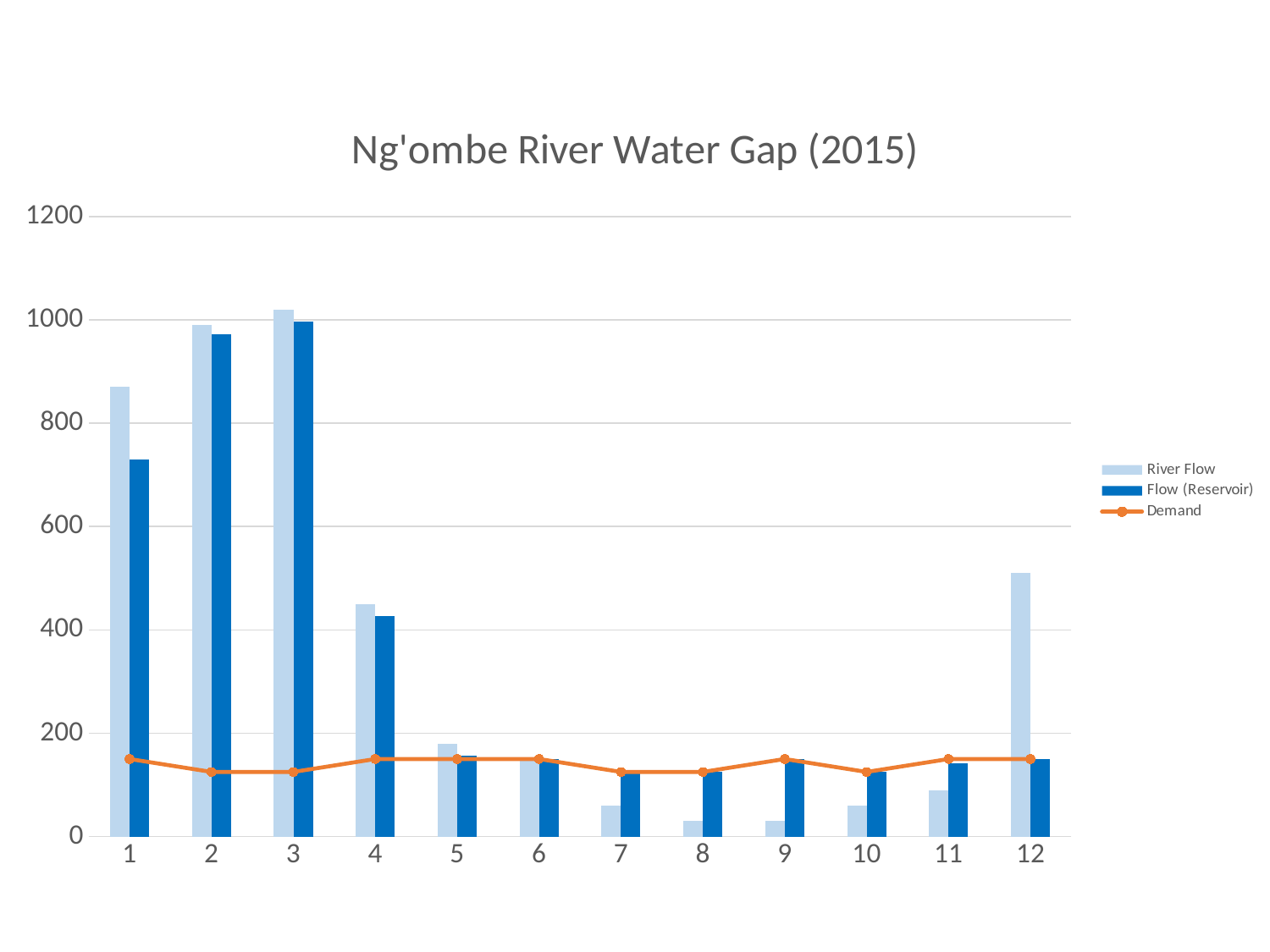
Is the Flow (Reservoir) value for category 1 greater or less than 800? less Is the River Flow value for category 1 greater or less than 800? greater Is the River Flow value for category 8 greater or less than 200? less Which series is drawn as a line rather than bars? Demand Which category has the highest River Flow value? 3 How many categories are shown on the x axis? 12 For category 1, which is larger: River Flow or Flow (Reservoir)? River Flow Do the River Flow values rise or fall from category 3 to category 8? fall Which has the larger River Flow value: category 2 or category 4? 2 What is the title of the chart? Ng'ombe River Water Gap (2015) How many series does the legend list? 3